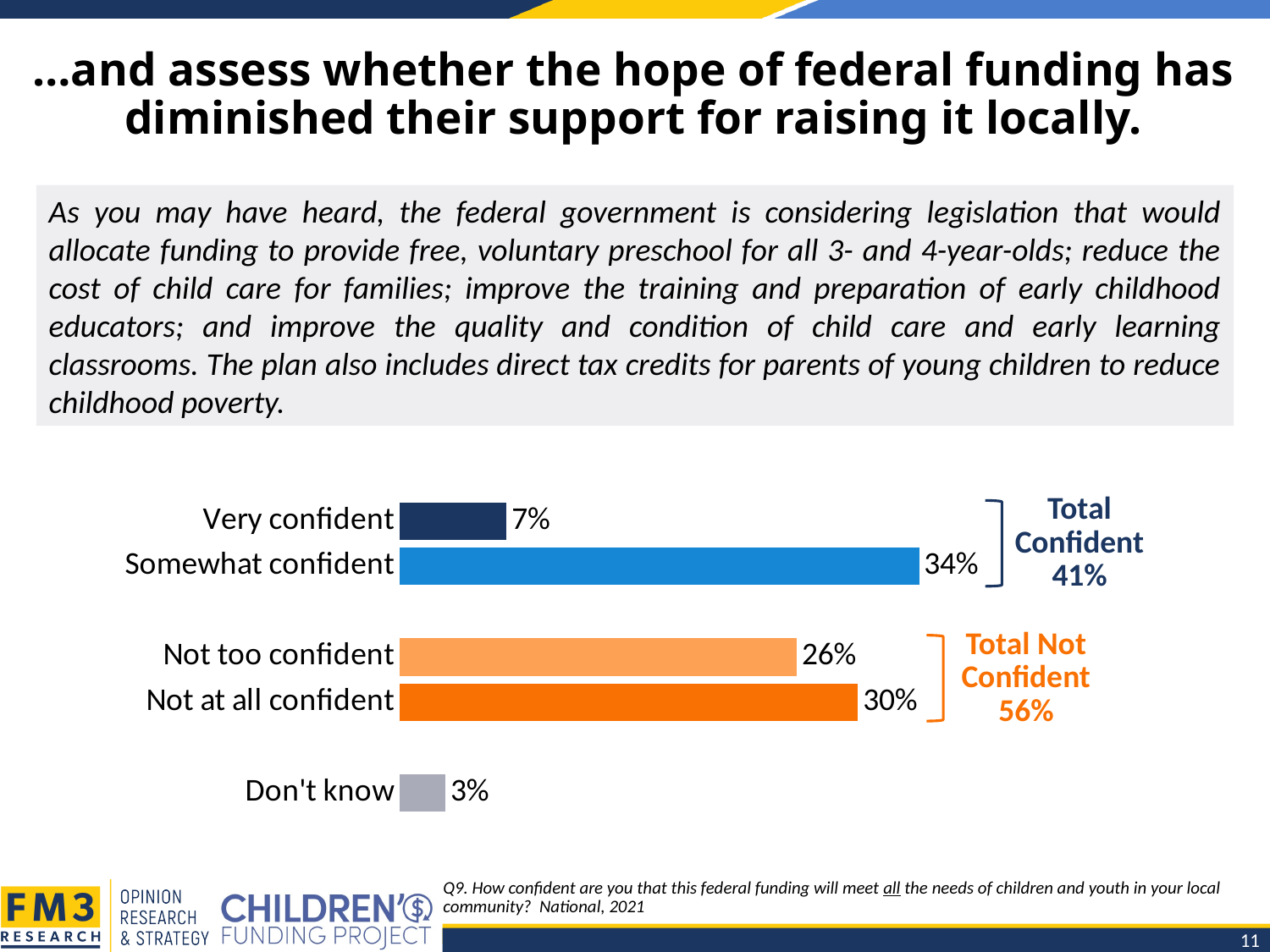
Which response category has the highest percentage? Somewhat confident What percentage of respondents said they were not at all confident? 30% How many response categories are shown in the chart? 5 What percentage of respondents said they were very confident? 7% What type of chart is shown on the slide? Bar chart Which response category has the lowest percentage? Don't know What is the difference in percentage points between not at all confident and not too confident? 4 What percentage of respondents said they were not too confident? 26% Which is larger, the percentage for somewhat confident or for not at all confident? Somewhat confident What percentage of respondents said they were somewhat confident? 34% What is the Total Not Confident percentage shown next to the chart? 56% What percentage of respondents answered don't know? 3%